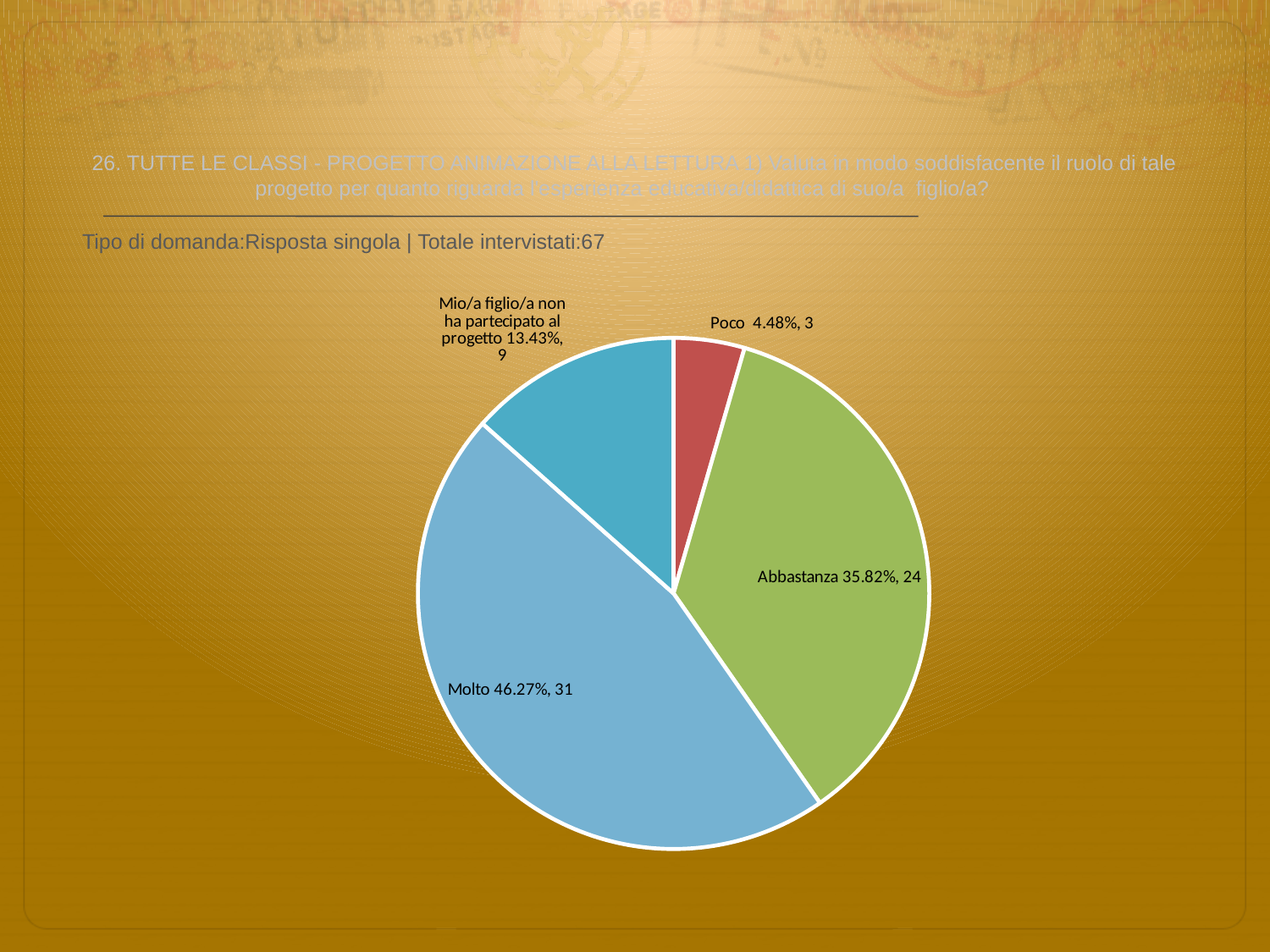
What percentage share does the 'Poco' slice have? 4.48% How many respondents answered 'Abbastanza'? 24 How many respondents answered 'Mio/a figlio/a non ha partecipato al progetto'? 9 What percentage share does the 'Molto' slice have? 46.27% Which has more respondents, 'Abbastanza' or 'Mio/a figlio/a non ha partecipato al progetto'? Abbastanza What is the difference in respondent count between 'Molto' and 'Abbastanza'? 7 Which category has the largest slice of the pie? Molto What kind of chart is shown on the slide? pie chart Which category has the smallest slice of the pie? Poco How many slices does the pie chart have? 4 What is the total number of respondents (Totale intervistati) stated on the slide? 67 What colour is the 'Poco' slice? red